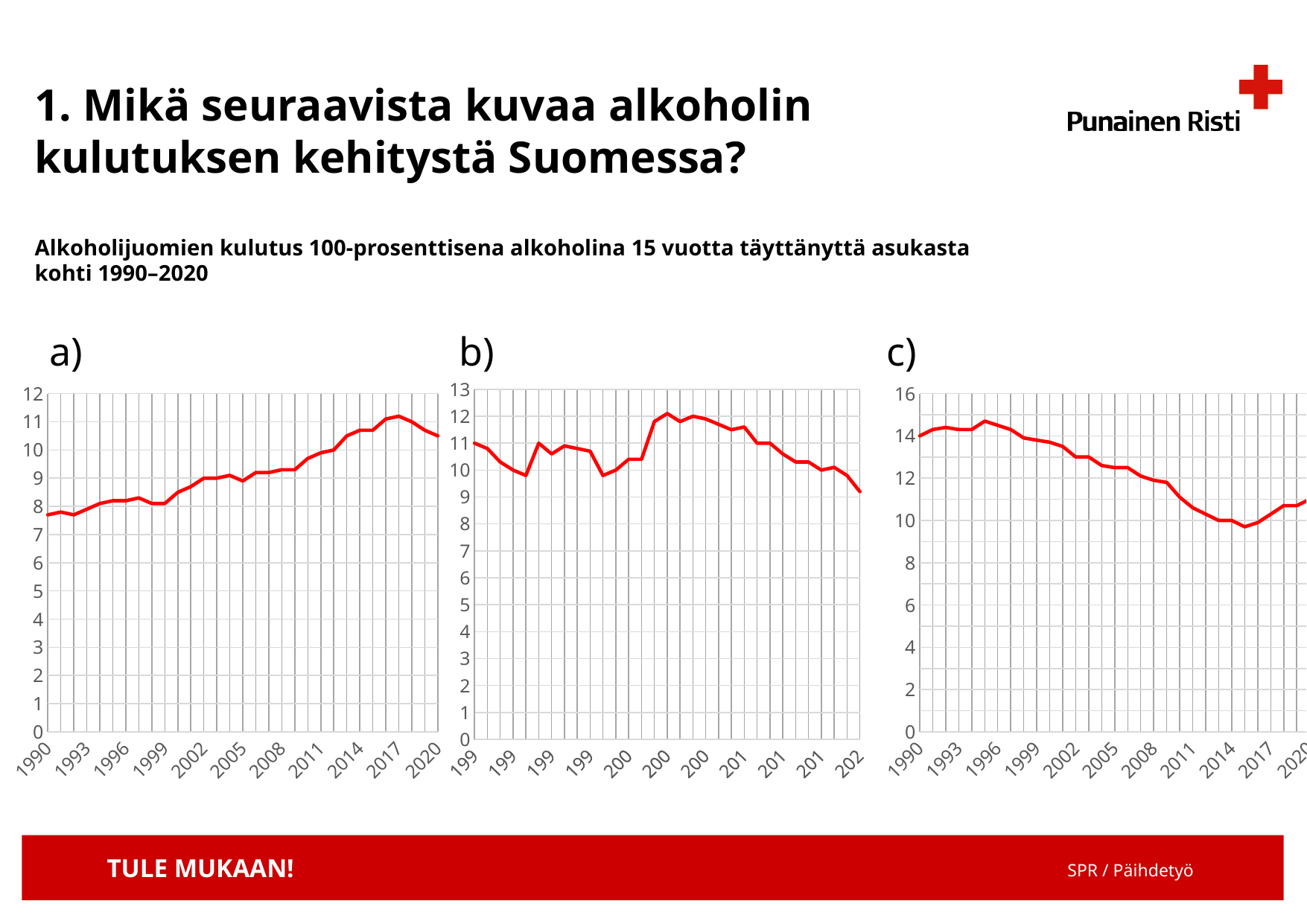
In chart b), does the line rise or fall between 2008 and 2020? fall In chart c), which year has the higher value, 1990 or 2020? 1990 In chart a), is the value for 1990 greater or less than 9? less How many charts are shown on the slide? 3 What kind of chart is chart a)? line chart What is the highest value shown on the y axis of chart c)? 16 In chart c), is the value for 1990 greater or less than 12? greater In chart a), is the value for 2017 greater or less than 10? greater In chart c), does the line rise or fall between 1996 and 2014? fall In chart a), does the line generally rise or fall between 1990 and 2017? rise